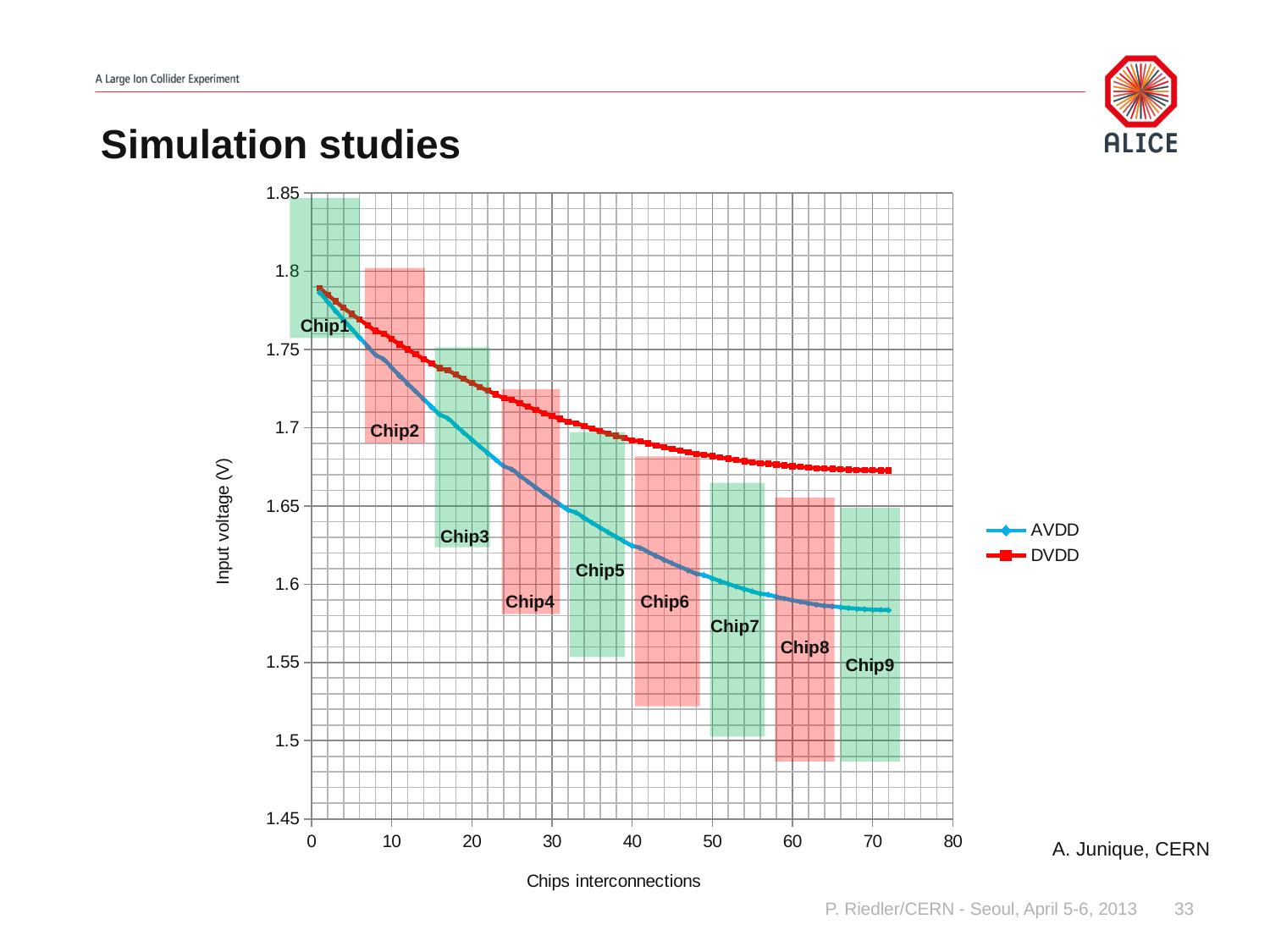
What is the label of the x axis? Chips interconnections What kind of chart is shown on the slide? line chart At 60 chip interconnections, which series has the higher input voltage, AVDD or DVDD? DVDD Do the AVDD values rise or fall as the number of chip interconnections increases? fall Is the AVDD value at 40 chip interconnections greater or less than 1.65? less What are the two series named in the legend? AVDD and DVDD How many series does the legend list? 2 Do the DVDD values rise or fall along the x axis? fall Is the DVDD value at 30 chip interconnections greater or less than 1.7? greater Is the AVDD value at 70 chip interconnections greater or less than 1.6? less How many chip regions (Chip1, Chip2, ...) are marked on the chart? 9